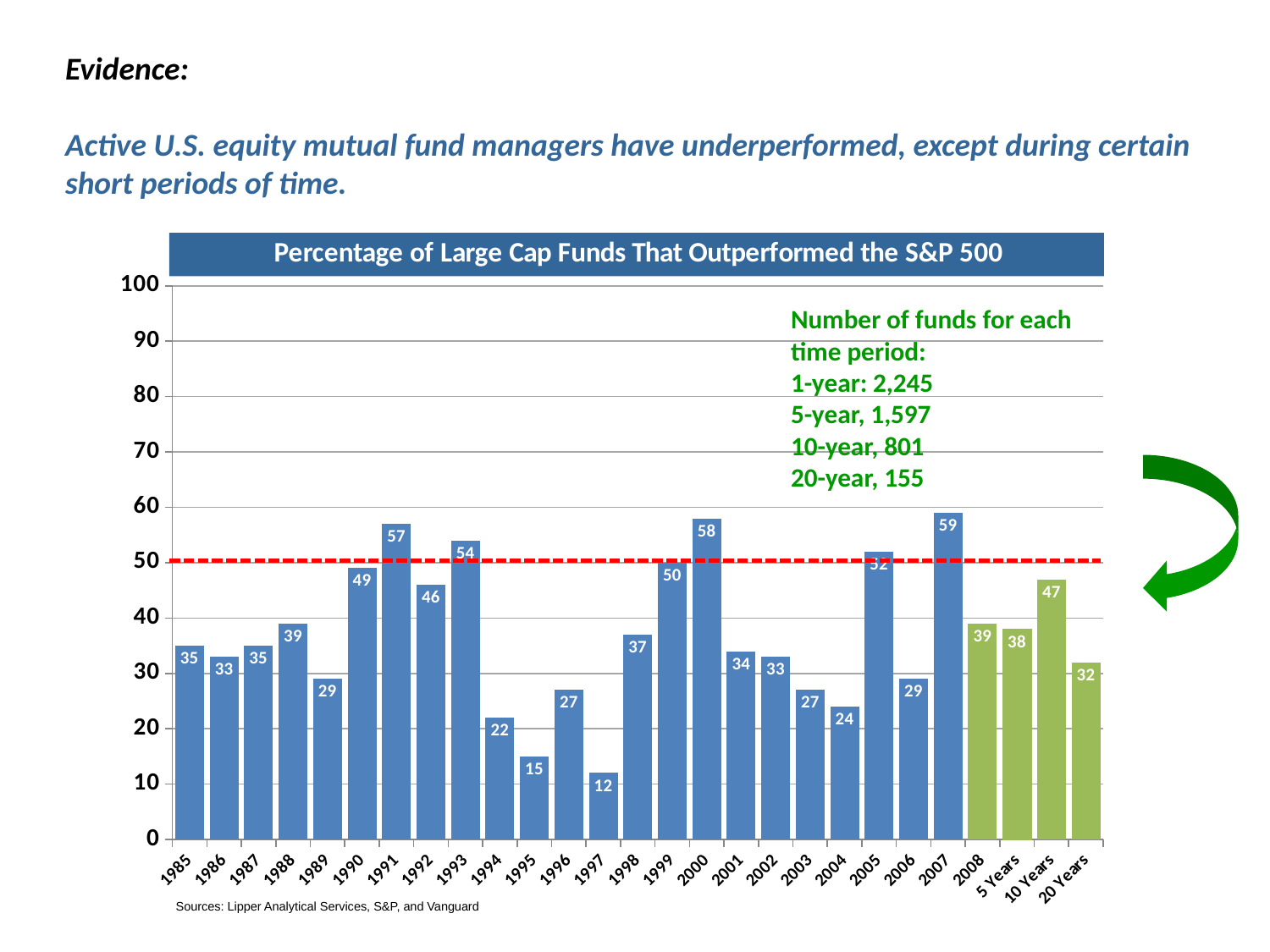
Which category has the highest value? 2007 What is the difference between the values for 2007 and 1997? 47 Which is larger, the value for 1991 or the value for 1992? 1991 How many categories are shown on the x axis? 27 What is the difference between the values for 10 Years and 20 Years? 15 What is the value for 2000? 58 What kind of chart is this? Bar chart What is the value for 1993? 54 What is the value for 1997? 12 Which category has the lowest value? 1997 What is the value for 10 Years? 47 What is the title of the chart? Percentage of Large Cap Funds That Outperformed the S&P 500